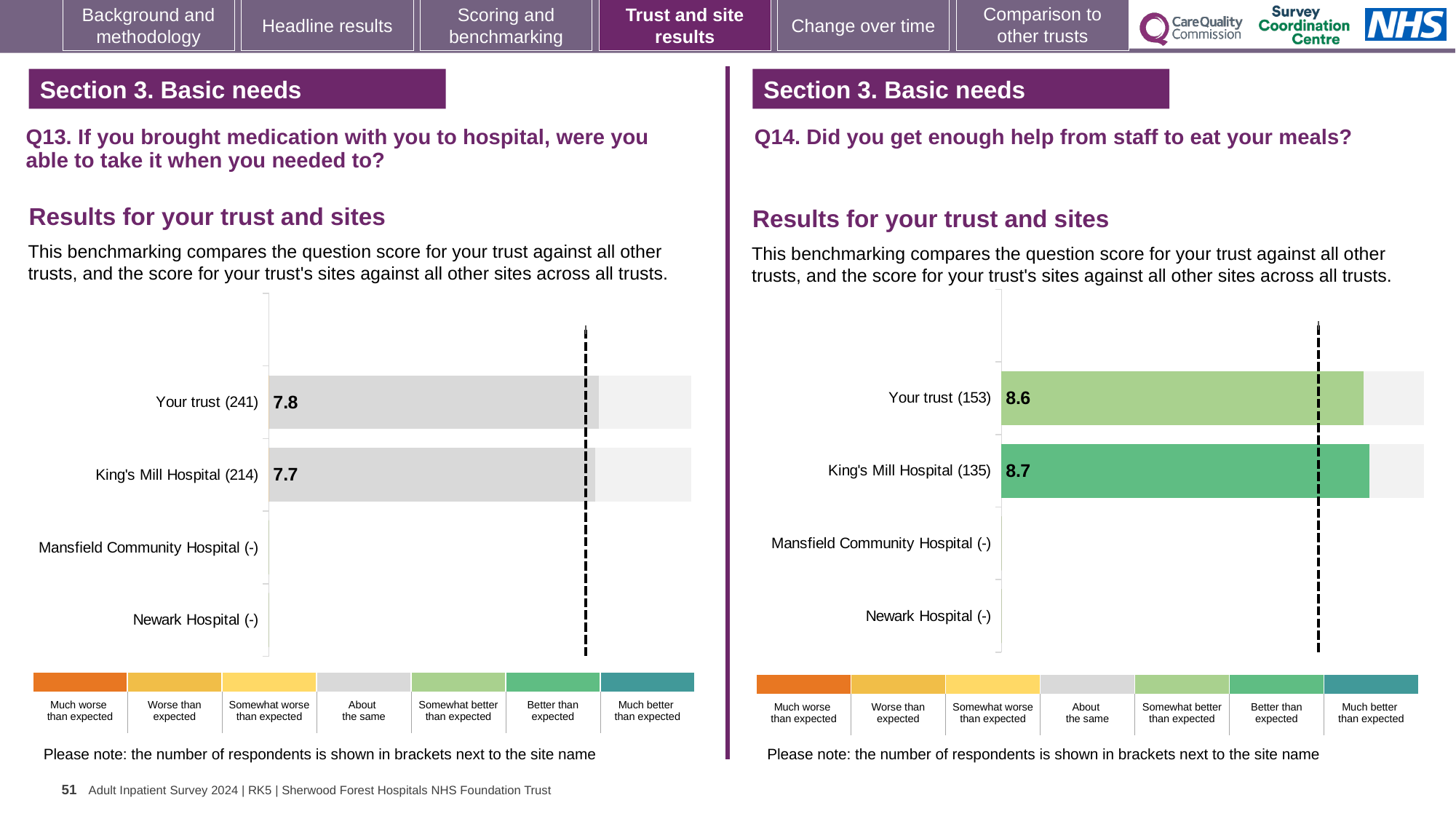
On the Q14 chart (right), which has the higher score, Your trust or King's Mill Hospital? King's Mill Hospital On the Q14 chart (right), how many respondents are shown in brackets for King's Mill Hospital? 135 On the Q14 chart (right), what is the score for King's Mill Hospital? 8.7 On the Q13 chart (left), what is the difference between the scores for Your trust and King's Mill Hospital? 0.1 On the Q13 chart (left), which has the higher score, Your trust or King's Mill Hospital? Your trust On the Q14 chart (right), what is the score for Your trust? 8.6 On the Q13 chart (left), what is the score for Your trust? 7.8 What kind of chart is used on the Q14 chart (right)? Bar chart On the Q13 chart (left), how many respondents are shown in brackets for Your trust? 241 On the Q14 chart (right), what is the difference between the scores for King's Mill Hospital and Your trust? 0.1 On the Q13 chart (left), what is the score for King's Mill Hospital? 7.7 How many site/trust categories are listed on the Q13 chart (left)? 4